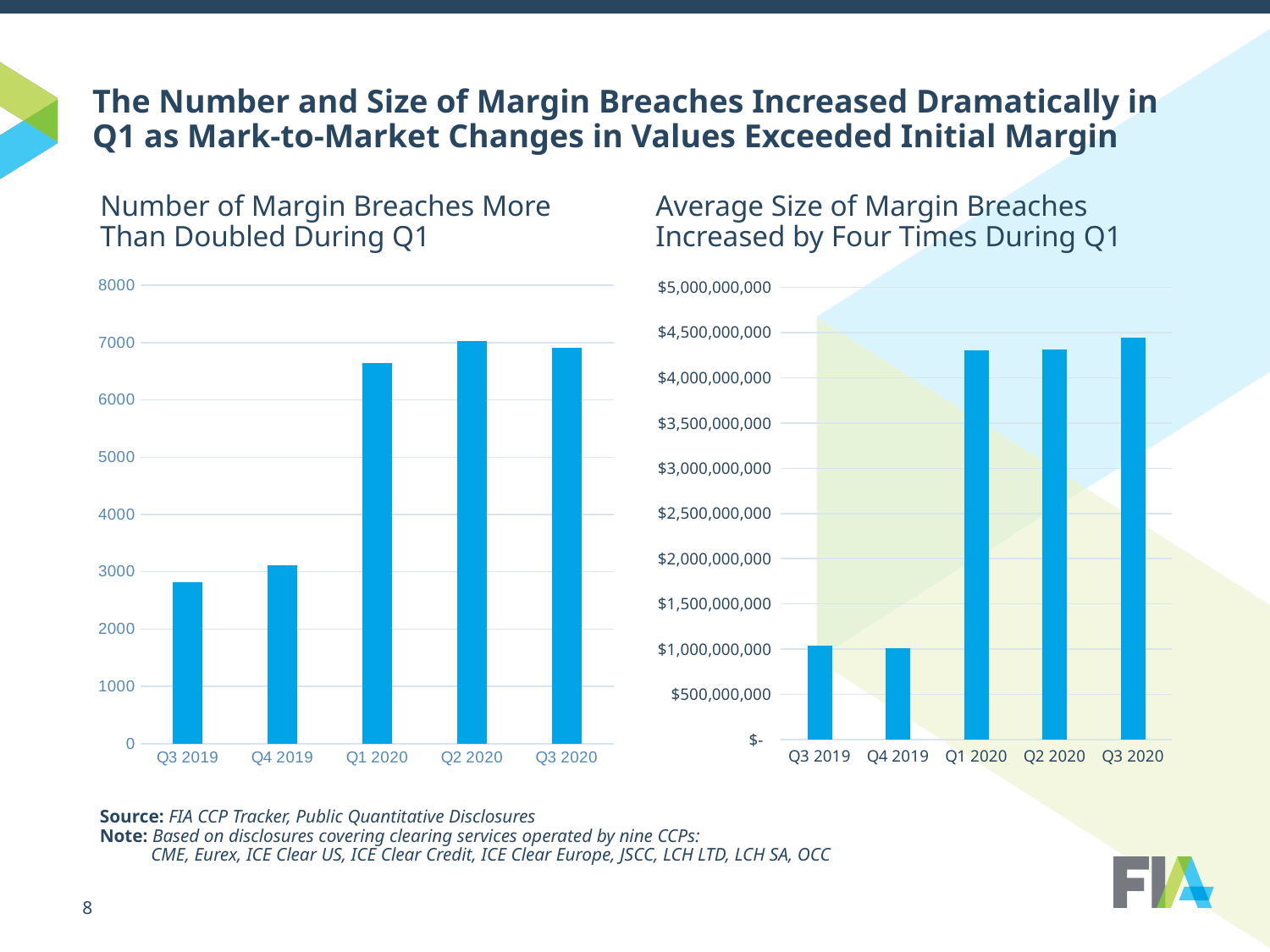
In the right chart, 'Average Size of Margin Breaches Increased by Four Times During Q1', which quarter has the highest value? Q3 2020 What kind of chart is the left chart, 'Number of Margin Breaches More Than Doubled During Q1'? Bar chart In the right chart, 'Average Size of Margin Breaches Increased by Four Times During Q1', which is larger: the value for Q3 2019 or the value for Q3 2020? Q3 2020 In the left chart, 'Number of Margin Breaches More Than Doubled During Q1', is the value for Q3 2019 greater or less than 3000? less In the left chart, 'Number of Margin Breaches More Than Doubled During Q1', which quarter has the lowest value? Q3 2019 What kind of chart is the right chart, 'Average Size of Margin Breaches Increased by Four Times During Q1'? Bar chart In the right chart, 'Average Size of Margin Breaches Increased by Four Times During Q1', is the value for Q1 2020 greater or less than $4,000,000,000? greater In the right chart, 'Average Size of Margin Breaches Increased by Four Times During Q1', is the value for Q4 2019 greater or less than $1,500,000,000? less How many quarters are shown on the x axis of the right chart, 'Average Size of Margin Breaches Increased by Four Times During Q1'? 5 How many quarters are shown on the x axis of the left chart, 'Number of Margin Breaches More Than Doubled During Q1'? 5 In the left chart, 'Number of Margin Breaches More Than Doubled During Q1', which is larger: the value for Q4 2019 or the value for Q1 2020? Q1 2020